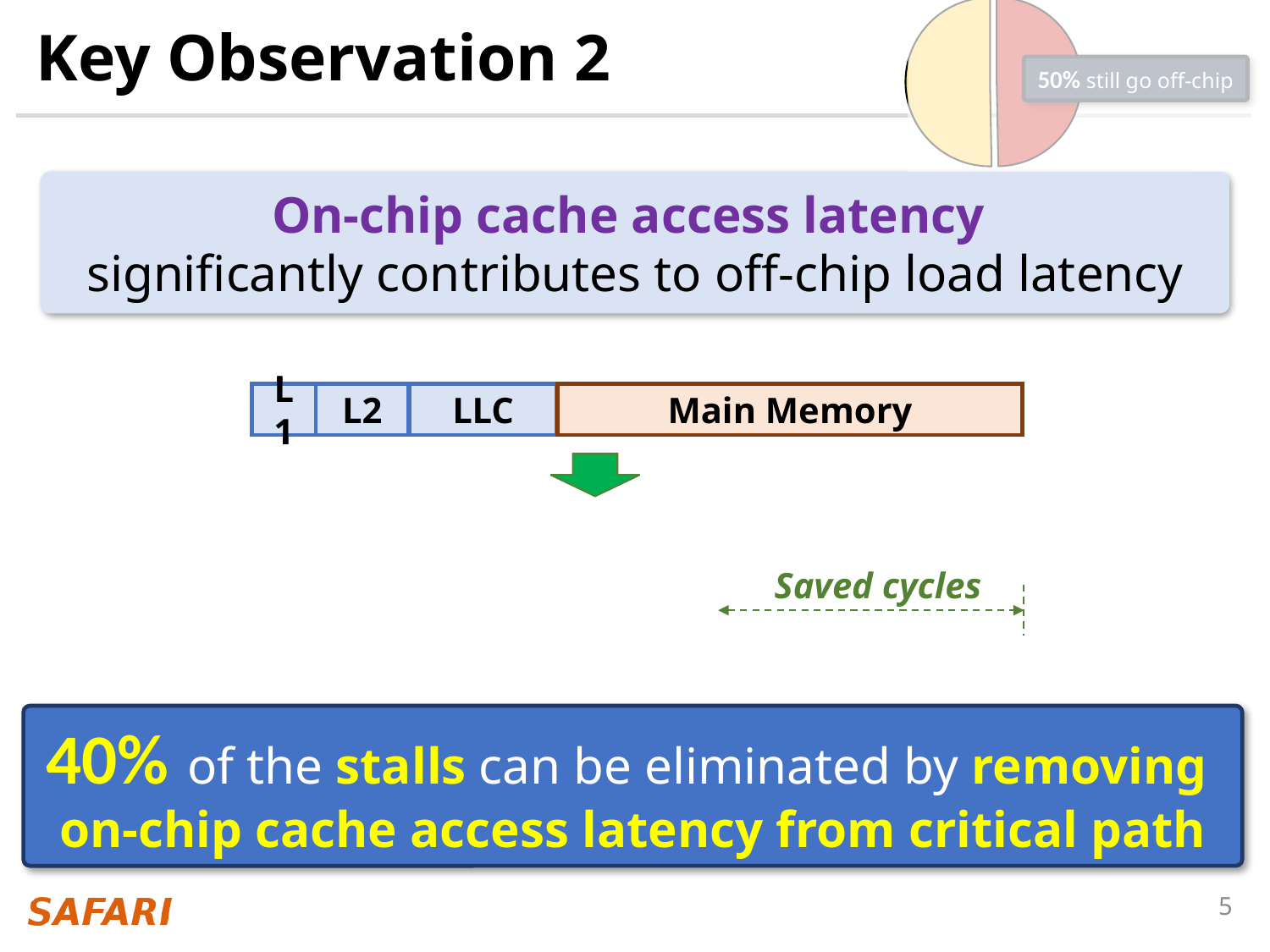
How many slices does the pie chart at the top right of the slide have? 2 In the pie chart at the top right, what colour is the slice labeled "50% still go off-chip"? red In the pie chart at the top right, what share is labeled "still go off-chip"? 50% In the pie chart at the top right, is the slice labeled "still go off-chip" greater or less than 25%? greater What kind of chart is shown in the top-right corner of the slide? pie chart